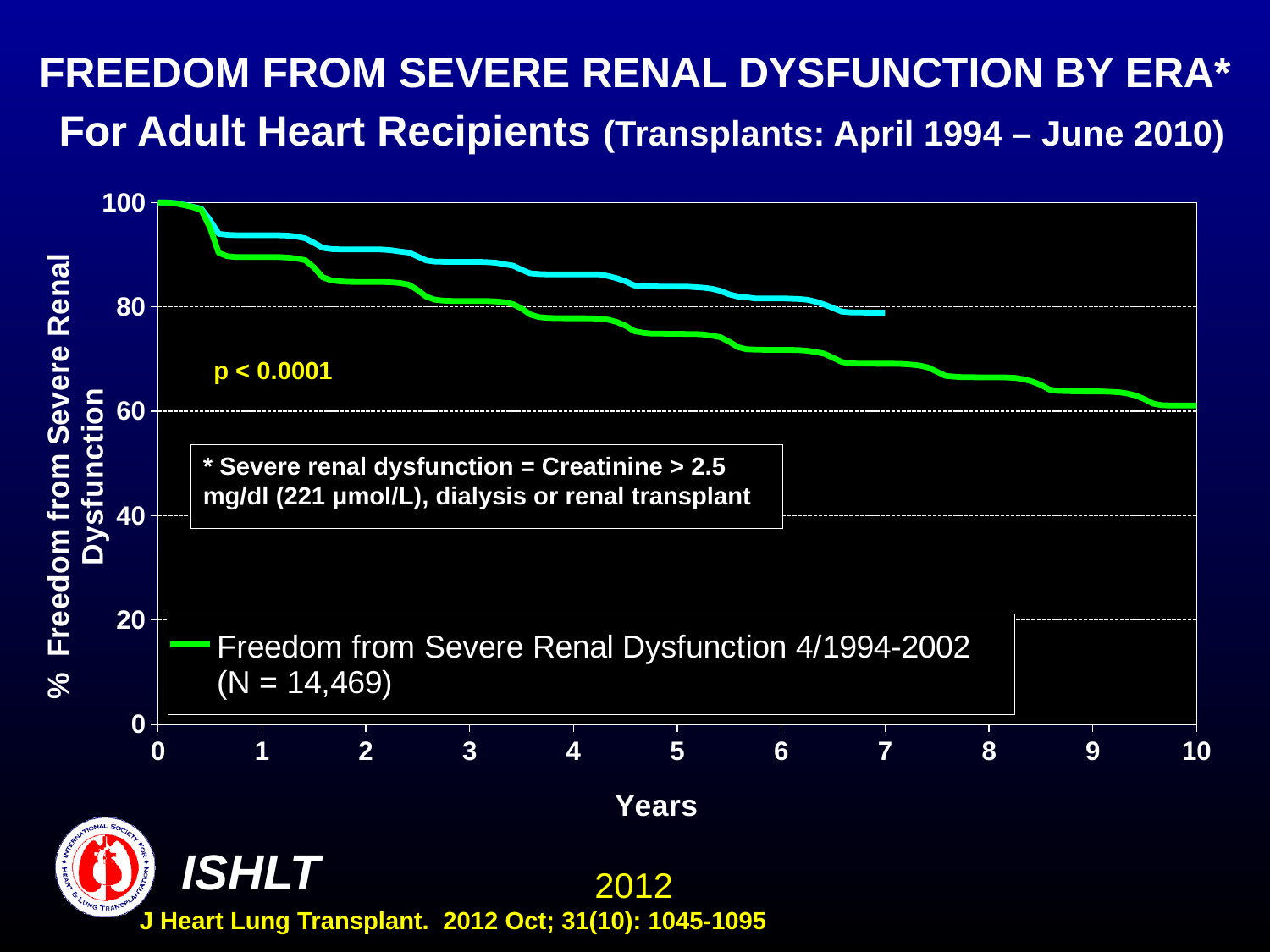
What is the label of the x axis? Years What p-value is printed on the chart? p < 0.0001 What is the N value given in the legend for the 4/1994-2002 series? 14,469 Does the green line rise or fall as the years increase along the x axis? fall What is the highest value shown on the y axis? 100 Is the value of the green 4/1994-2002 line at 8 years greater or less than 80? less Is the value of the green 4/1994-2002 line at 1 year greater or less than 80? greater Is the value of the green 4/1994-2002 line at 5 years greater or less than 80? less How many series does the legend list? 1 At 3 years, which line is higher, the green line or the cyan line? the cyan line What kind of chart is shown on the slide? line chart